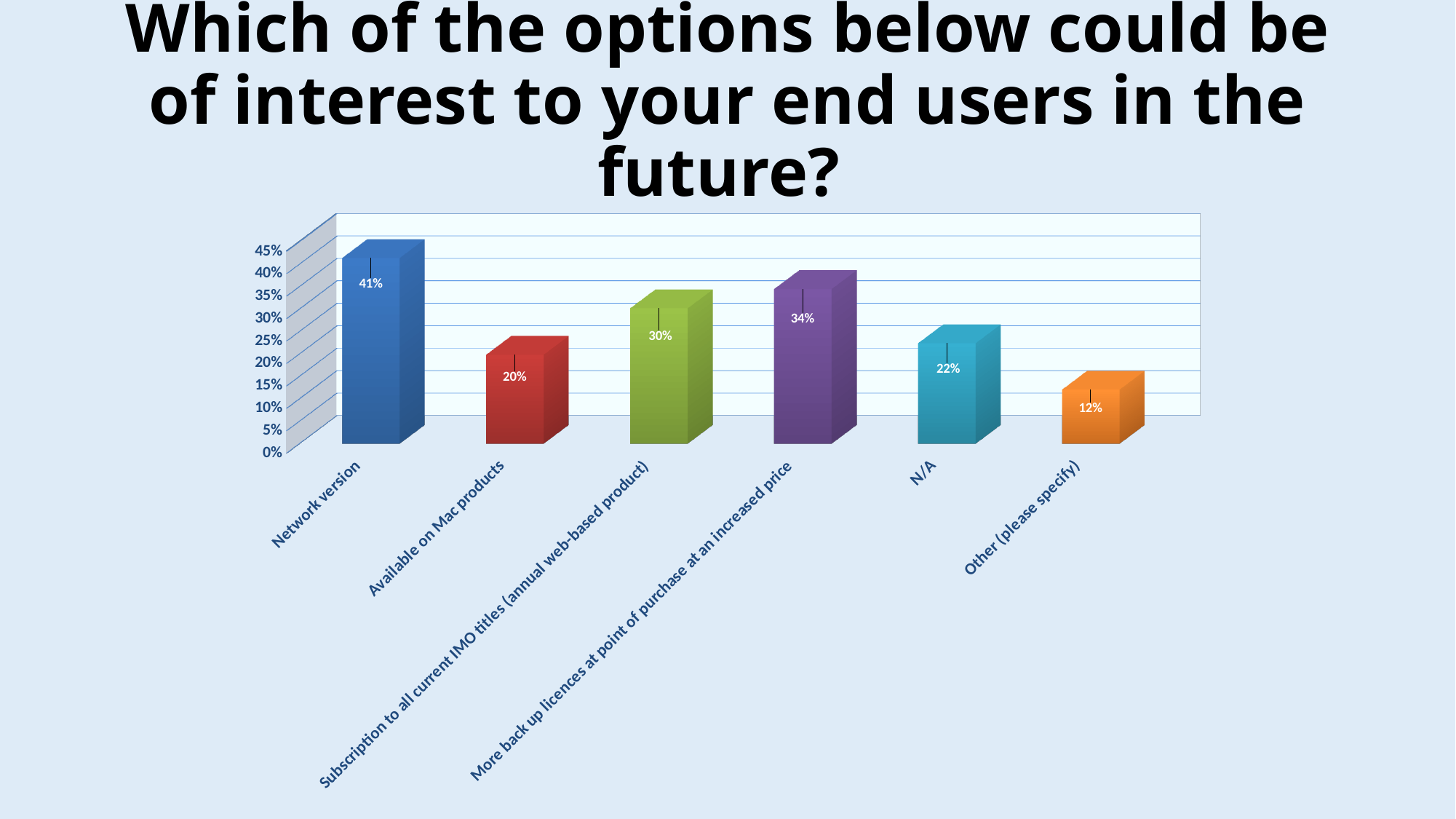
What is the value for Network version? 41% Which option has the lowest value? Other (please specify) What is the value for Available on Mac products? 20% What is the value for Subscription to all current IMO titles (annual web-based product)? 30% What kind of chart is shown on the slide? Bar chart What is the difference between the values for Network version and Other (please specify)? 29% How many options are shown in the chart? 6 Which is larger, the value for N/A or the value for Available on Mac products? N/A What is the value for More back up licences at point of purchase at an increased price? 34% Which option has the highest value? Network version What is the value for Other (please specify)? 12% What is the value for N/A? 22%